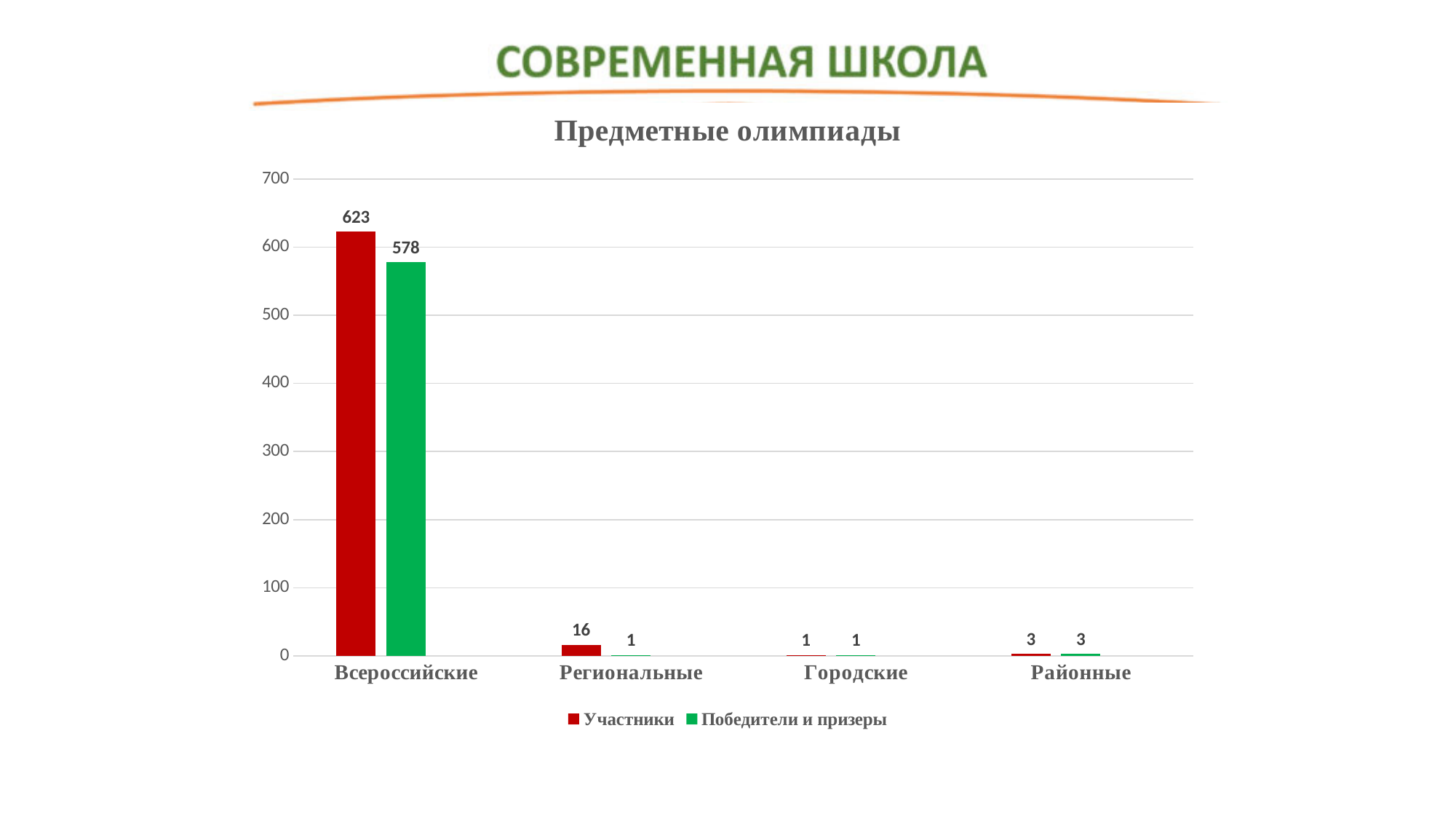
What is the value for Участники in the Всероссийские category? 623 What is the value for Победители и призеры in the Районные category? 3 What is the value for Участники in the Региональные category? 16 How many categories are shown on the x axis? 4 What is the value for Победители и призеры in the Всероссийские category? 578 Is the value for Участники in the Всероссийские category greater or less than 600? greater Which category has the highest value for Участники? Всероссийские What is the difference between Участники and Победители и призеры in the Всероссийские category? 45 Which category has the lowest value for Участники? Городские What kind of chart is shown on the slide? Bar chart Which is larger in the Региональные category: Участники or Победители и призеры? Участники How many series does the legend list? 2